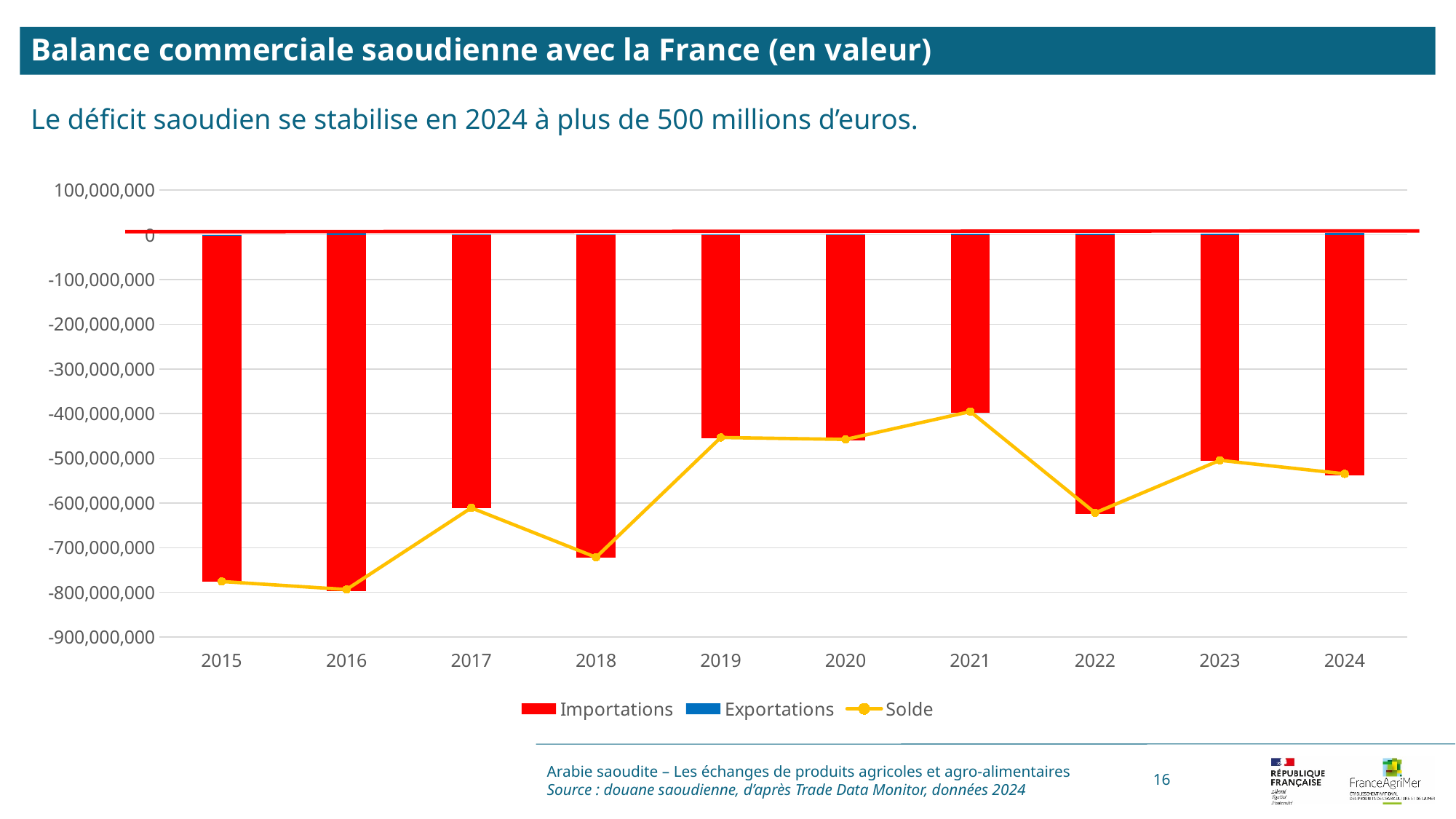
Does the Solde line rise or fall between 2021 and 2022? fall In which year is the Solde line at its highest point? 2021 In which year is the Solde line at its lowest point? 2016 Is the Solde value for 2019 greater or less than -500,000,000? greater How many series does the chart legend list? 3 Is the Solde value for 2024 greater or less than -500,000,000? less What kind of chart is shown on the slide? A combined bar and line chart How many years are shown on the x axis of the chart? 10 Is the Solde value for 2015 greater or less than -700,000,000? less What is the title of the chart on the slide? Balance commerciale saoudienne avec la France (en valeur) Which year has the higher Solde value, 2016 or 2017? 2017 Which series is drawn as a line with markers in the chart? Solde